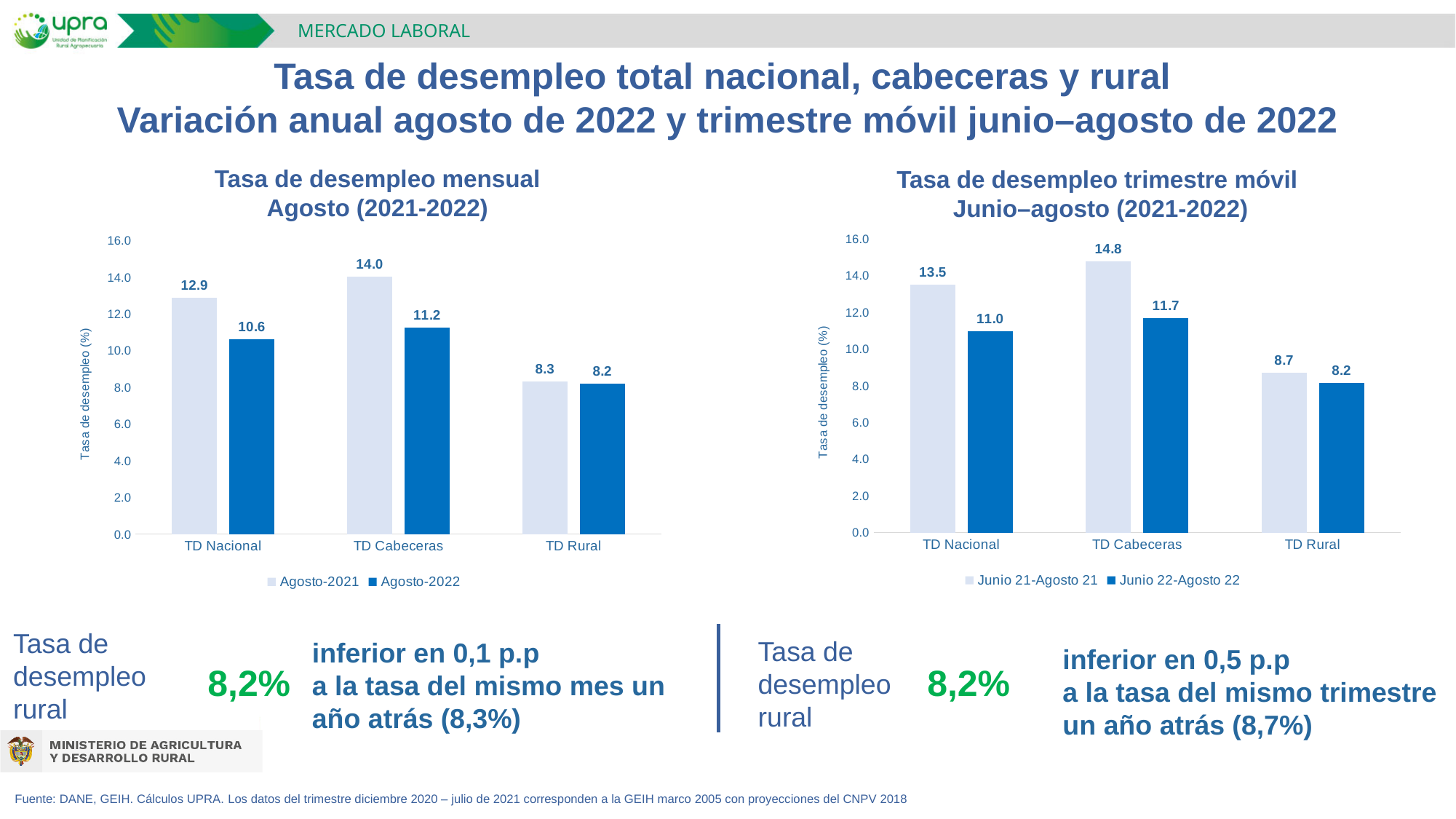
In the right chart (Tasa de desempleo trimestre móvil), which is larger: TD Nacional for Junio 22-Agosto 22 or TD Cabeceras for Junio 22-Agosto 22? TD Cabeceras In the right chart (Tasa de desempleo trimestre móvil), which category has the highest value for Junio 22-Agosto 22? TD Cabeceras In the left chart (Tasa de desempleo mensual Agosto), what is the value for TD Nacional in Agosto-2022? 10.6 In the left chart (Tasa de desempleo mensual Agosto), what is the value for TD Cabeceras in Agosto-2021? 14.0 In the right chart (Tasa de desempleo trimestre móvil), what is the value for TD Rural in Junio 21-Agosto 21? 8.7 In the right chart (Tasa de desempleo trimestre móvil), what is the difference between the Junio 21-Agosto 21 and Junio 22-Agosto 22 values for TD Nacional? 2.5 How many categories are shown on the x axis of the right chart (Tasa de desempleo trimestre móvil)? 3 In the left chart (Tasa de desempleo mensual Agosto), which category has the lowest value for Agosto-2021? TD Rural In the left chart (Tasa de desempleo mensual Agosto), is the value for TD Nacional in Agosto-2021 greater or less than 12.0? greater In the left chart (Tasa de desempleo mensual Agosto), what is the difference between the Agosto-2021 and Agosto-2022 values for TD Cabeceras? 2.8 What kind of chart is the right chart (Tasa de desempleo trimestre móvil)? Bar chart How many series does the legend of the left chart (Tasa de desempleo mensual Agosto) list? 2